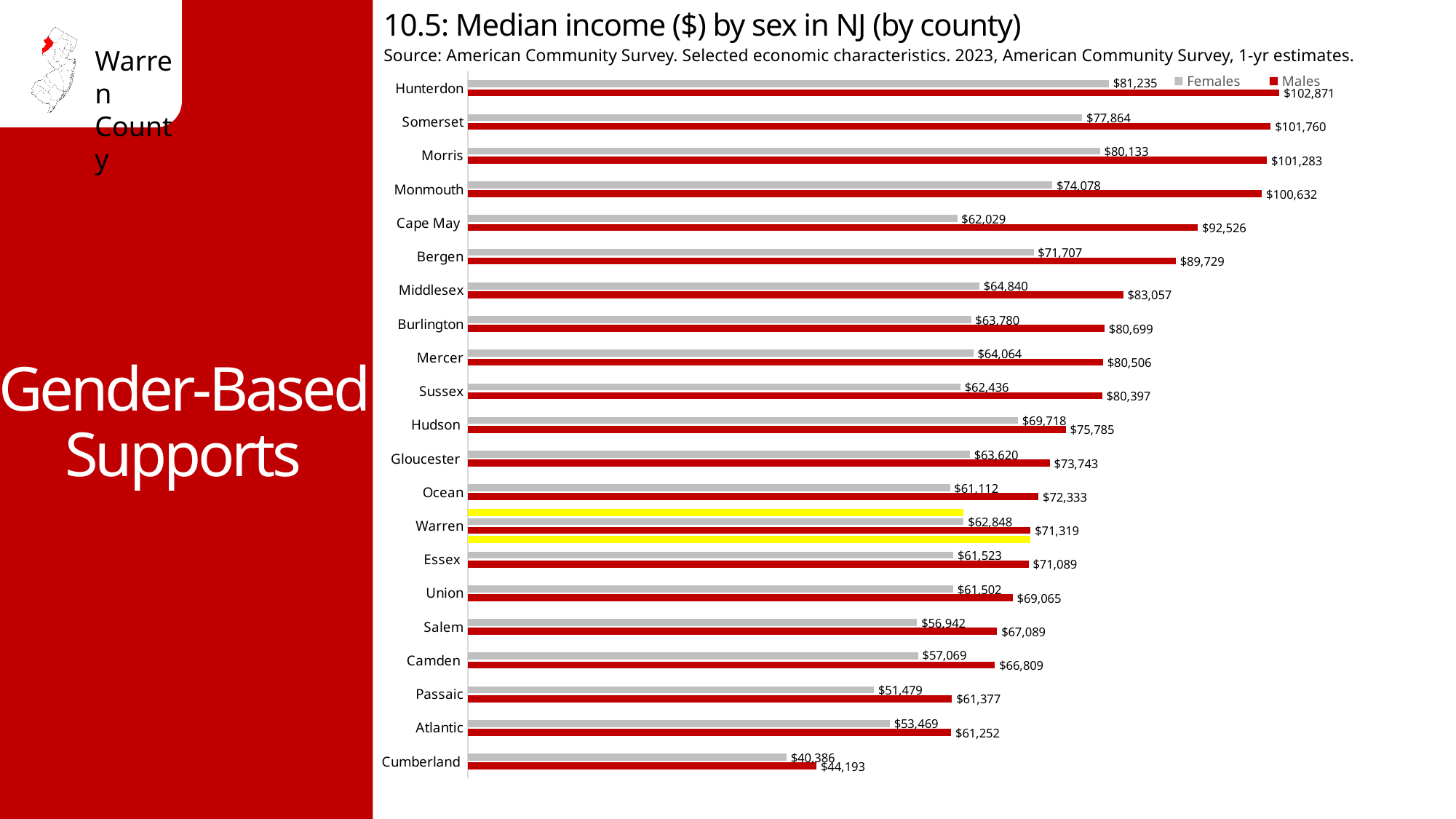
How many counties are shown in the chart? 21 What is the median income for females in Cumberland County? $40,386 Which is larger, the median income for males in Bergen County or in Cape May County? Cape May What type of chart is shown on the slide? Bar chart Which county has the highest median income for females? Hunterdon Which county has the lowest median income for males? Cumberland What is the median income for females in Warren County? $62,848 What is the difference between the male and female median income in Hunterdon County? $21,636 What is the median income for males in Hunterdon County? $102,871 How many series does the legend list? 2 What is the median income for males in Warren County? $71,319 What is the difference between the male and female median income in Warren County? $8,471